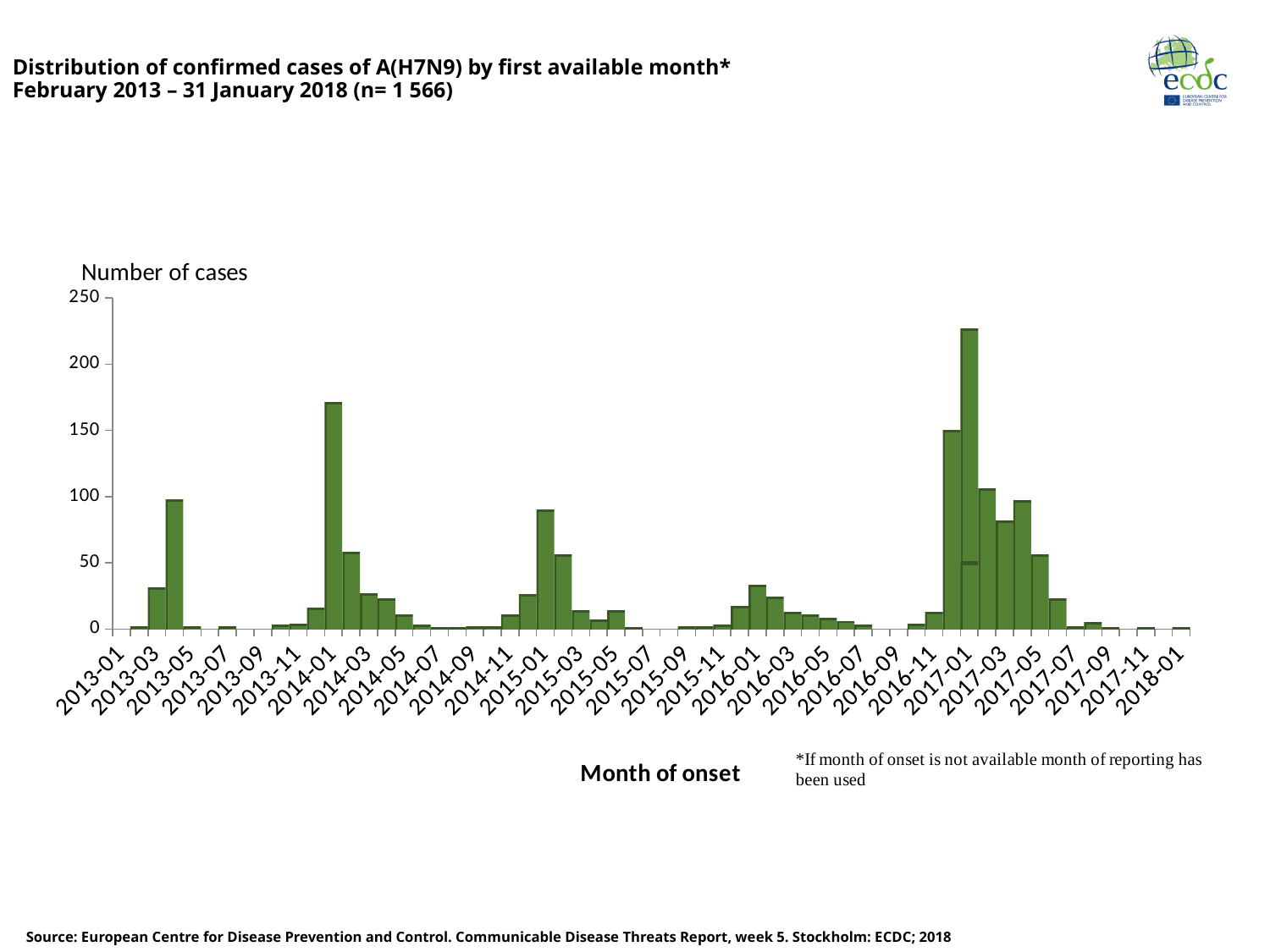
Is the number of cases for 2017-01 greater or less than 200? greater Do the number of cases rise or fall from 2017-01 to 2017-03? fall What is the title of the horizontal axis? Month of onset Which month has the highest number of cases? 2017-01 What is the label of the vertical axis? Number of cases Is the number of cases for 2016-01 greater or less than 50? less Which month has more cases, 2014-01 or 2015-01? 2014-01 Is the number of cases for 2015-01 greater or less than 100? less What kind of chart is shown on the slide? bar chart Which month has more cases, 2017-01 or 2016-01? 2017-01